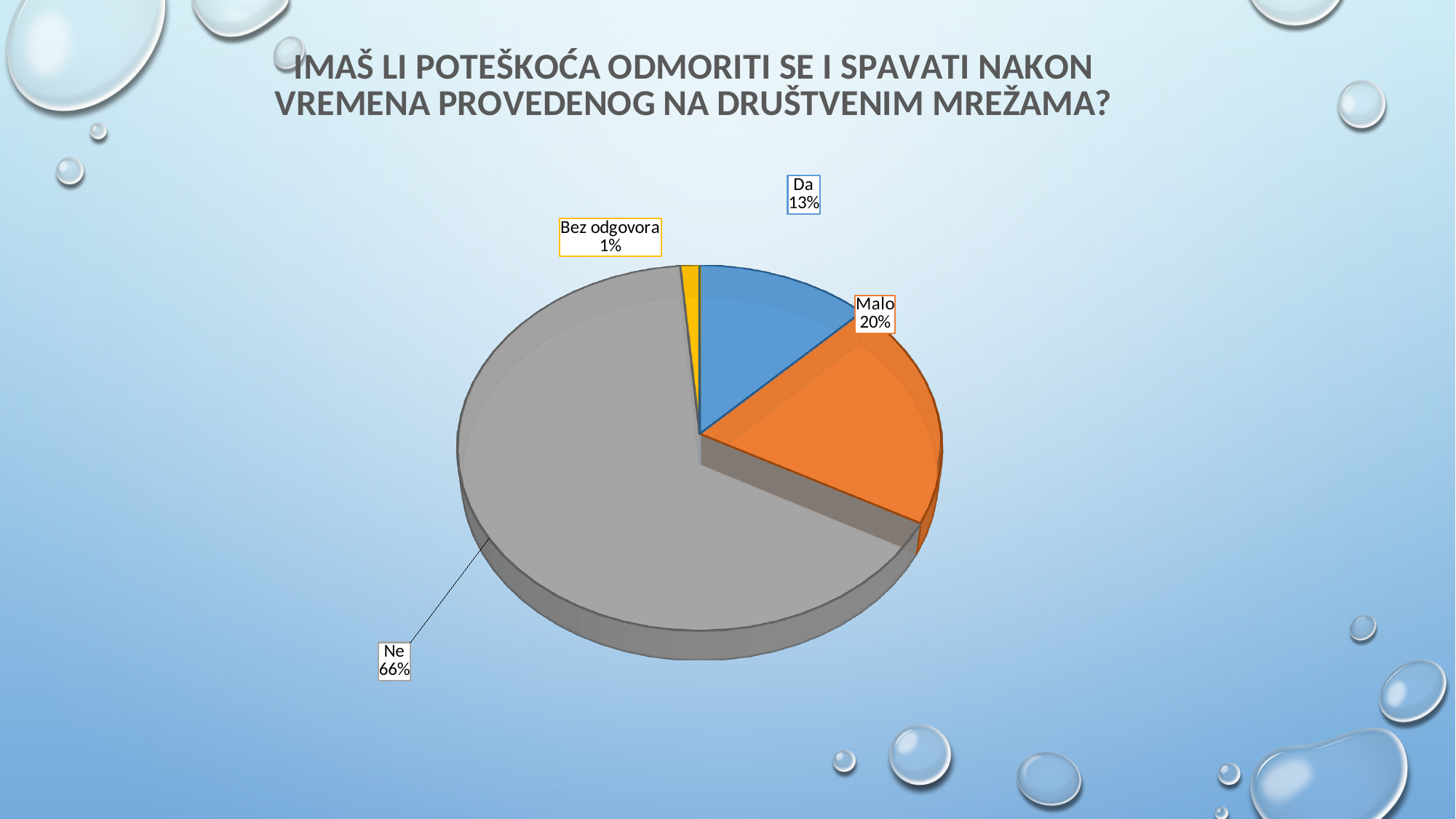
How many categories are shown in the pie chart? 4 Which is larger, the value for "Malo" or the value for "Da"? Malo Which category has the largest slice of the pie? Ne What is the difference between the values for "Ne" and "Malo"? 46% What colour is the "Ne" slice of the pie? grey Which category has the smallest slice of the pie? Bez odgovora What is the value shown for "Malo"? 20% What is the value shown for "Bez odgovora"? 1% What share of the pie does the "Ne" slice represent? 66% What is the difference between the values for "Malo" and "Da"? 7% What kind of chart is shown on the slide? pie chart What is the value shown for "Da"? 13%